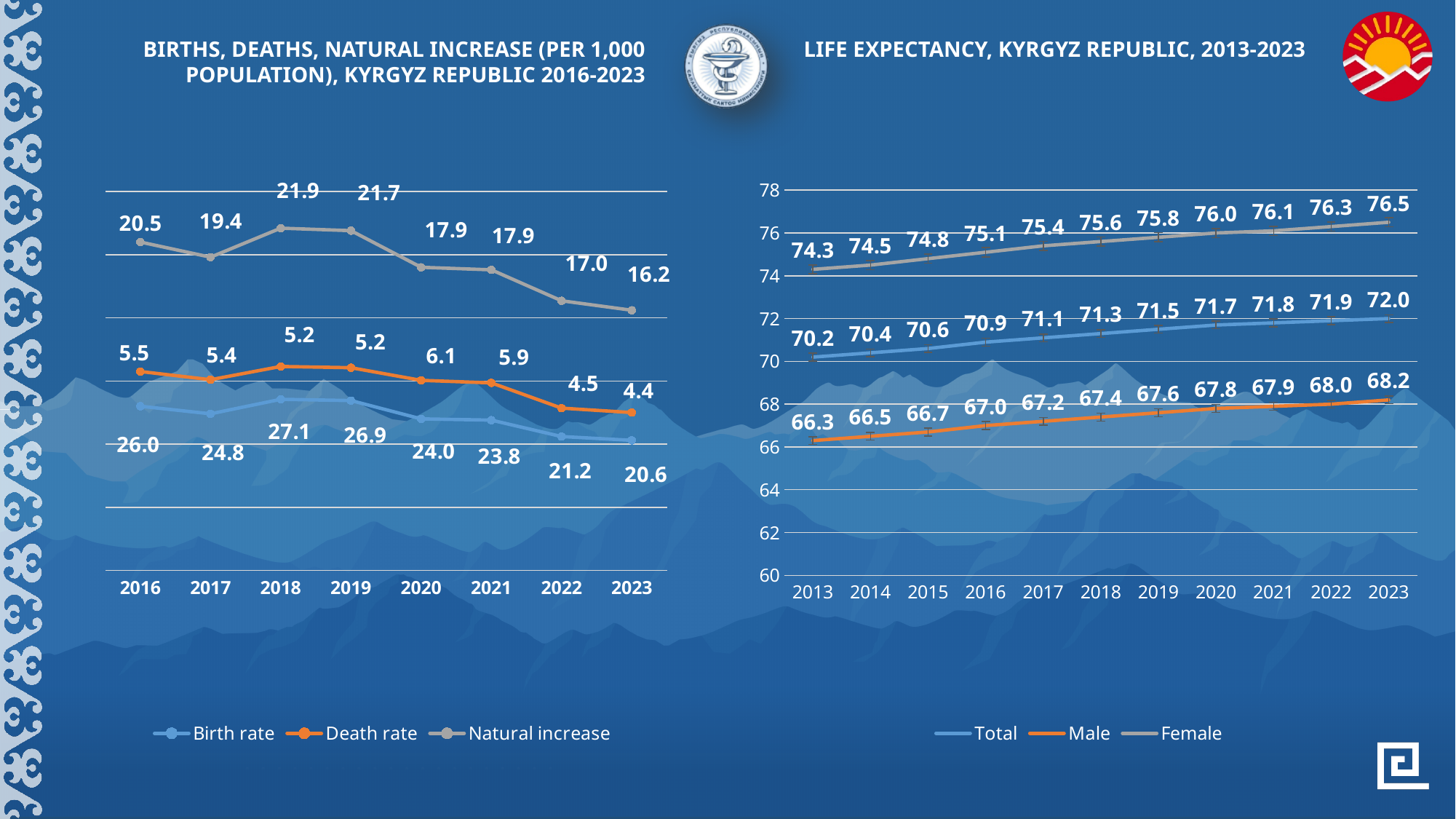
What kind of chart is the 'Life expectancy' chart? line chart In the 'Life expectancy' chart, what was the female life expectancy in 2023? 76.5 In the 'Life expectancy' chart, what is the difference between female and male life expectancy in 2023? 8.3 In the 'Life expectancy' chart, does the total life expectancy rise or fall from 2013 to 2023? rise In the 'Births, deaths, natural increase' chart, which year had the lowest natural increase? 2023 In the 'Births, deaths, natural increase' chart, what was the death rate in 2020? 6.1 In the 'Births, deaths, natural increase' chart, what was the birth rate in 2018? 27.1 In the 'Life expectancy' chart, what was the male life expectancy in 2013? 66.3 In the 'Life expectancy' chart, which is larger in 2018: the total life expectancy or the male life expectancy? Total In the 'Births, deaths, natural increase' chart, how many series does the legend list? 3 In the 'Births, deaths, natural increase' chart, how many years are shown on the x axis? 8 In the 'Births, deaths, natural increase' chart, what is the difference between the birth rate in 2016 and in 2023? 5.4